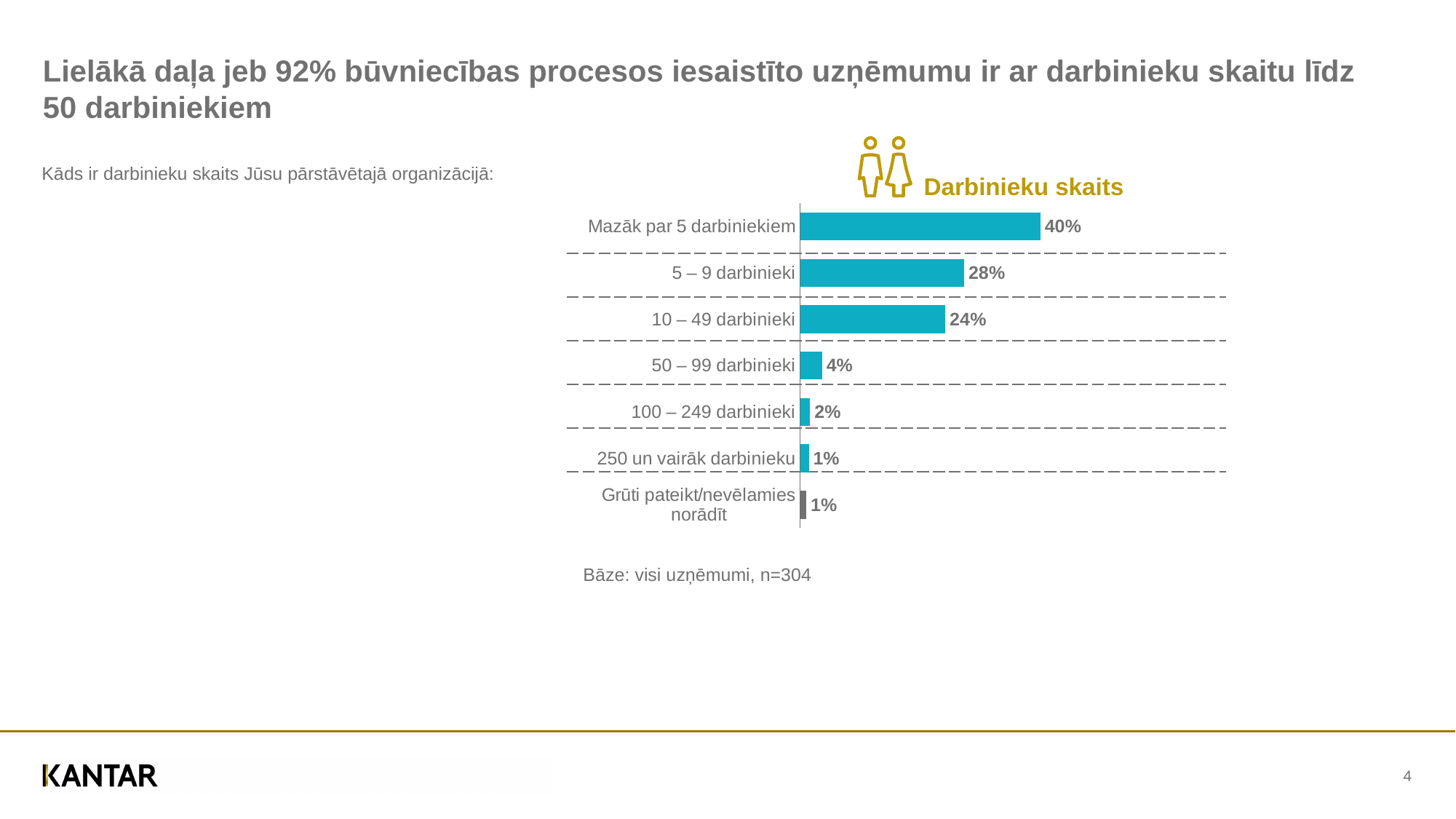
What is the value for the category '10 – 49 darbinieki'? 24% What is the sample size (n) stated below the chart? n=304 What is the difference between the values for 'Mazāk par 5 darbiniekiem' and '50 – 99 darbinieki'? 36% What is the difference between the values for '5 – 9 darbinieki' and '10 – 49 darbinieki'? 4% Which category has the highest value in the chart? Mazāk par 5 darbiniekiem Which is larger: the value for '50 – 99 darbinieki' or the value for '100 – 249 darbinieki'? 50 – 99 darbinieki What is the value for the category '100 – 249 darbinieki'? 2% How many categories are shown in the chart? 7 Which is larger: the value for '5 – 9 darbinieki' or the value for '10 – 49 darbinieki'? 5 – 9 darbinieki What is the title of the chart? Darbinieku skaits What kind of chart is shown on the slide? Bar chart What percentage of companies have fewer than 5 employees (Mazāk par 5 darbiniekiem)? 40%